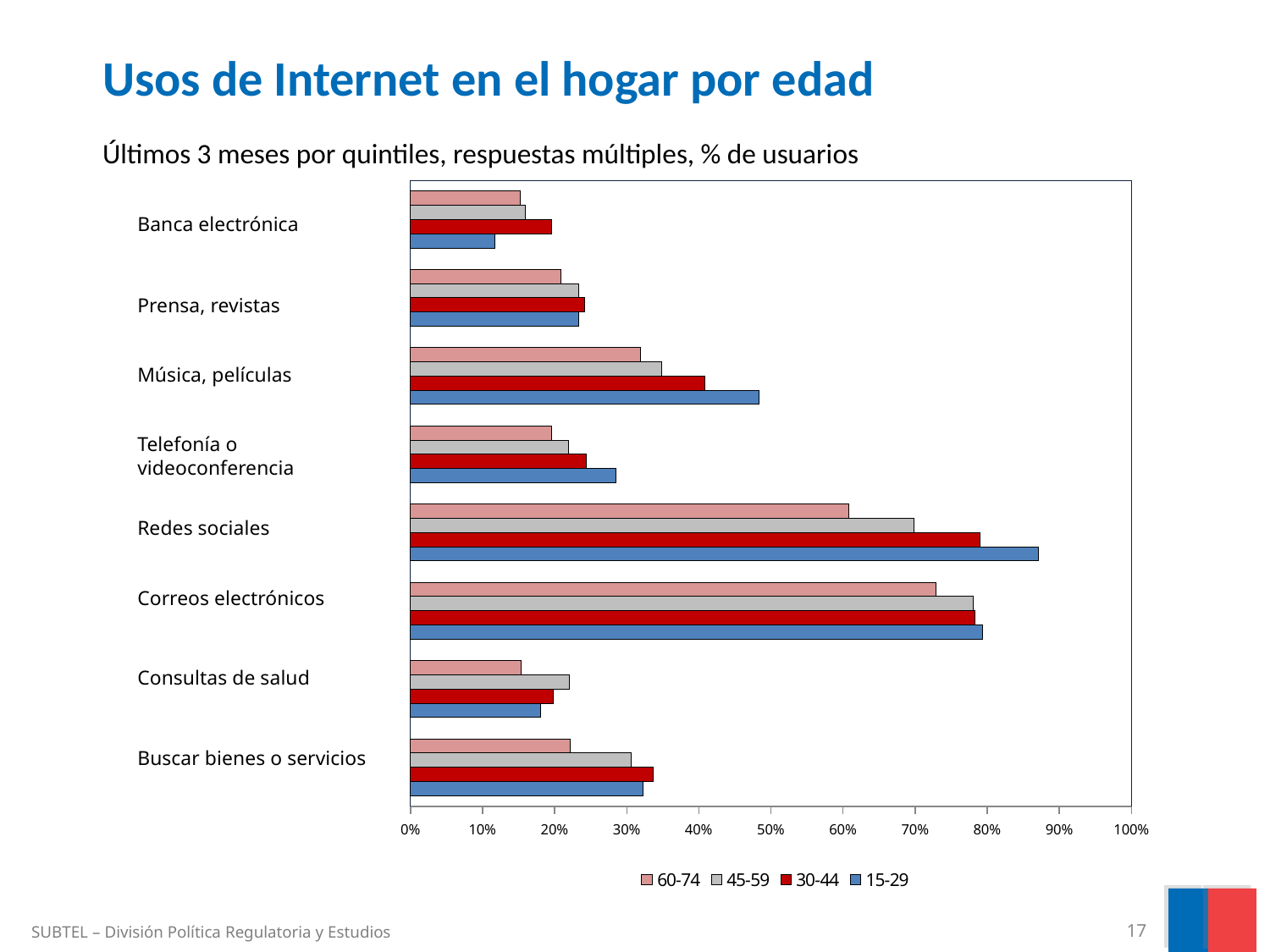
Is the value for Banca electrónica in the 15-29 age group greater or less than 20%? less In the 15-29 age group, which is larger: Música, películas or Telefonía o videoconferencia? Música, películas For Redes sociales, which age group has the higher value: 15-29 or 60-74? 15-29 How many Internet use categories are listed on the chart? 8 For Redes sociales, which age group has the lowest value? 60-74 For Música, películas, which age group has the highest value? 15-29 What kind of chart is shown on the slide? Bar chart Is the value for Correos electrónicos in the 60-74 age group greater or less than 70%? greater Is the value for Redes sociales in the 15-29 age group greater or less than 80%? greater Which age groups are listed in the legend? 60-74, 45-59, 30-44, 15-29 How many age groups does the legend list? 4